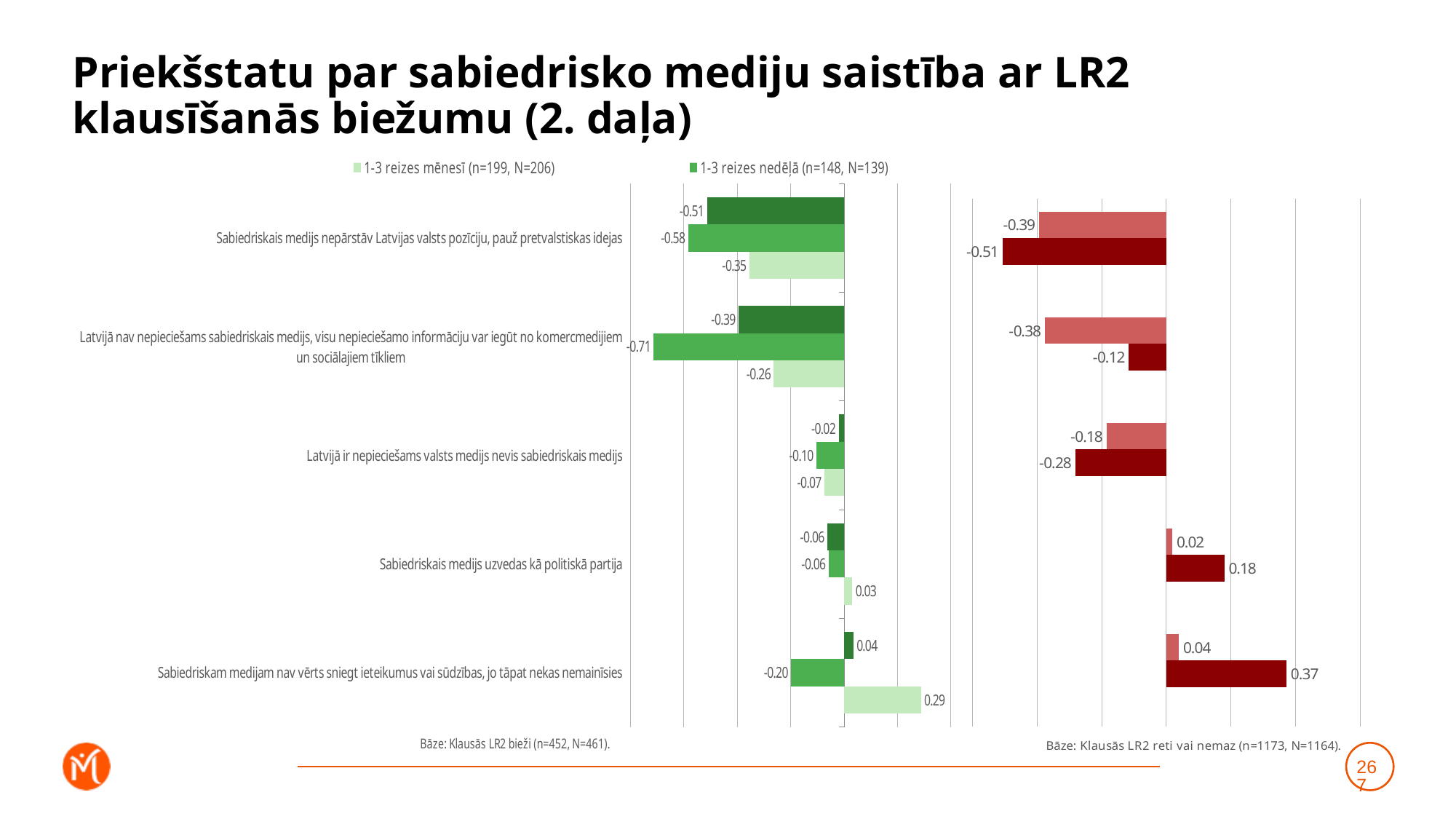
What type of chart is used on this slide? bar chart On the right chart, what is the value of the dark red bar for 'Sabiedriskam medijam nav vērts sniegt ieteikumus vai sūdzības, jo tāpat nekas nemainīsies'? 0.37 On the left chart, what is the value of the '1-3 reizes mēnesī' series for 'Sabiedriskais medijs nepārstāv Latvijas valsts pozīciju, pauž pretvalstiskas idejas'? -0.35 On the left chart, what is the value of the '1-3 reizes nedēļā' series for 'Latvijā nav nepieciešams sabiedriskais medijs, visu nepieciešamo informāciju var iegūt no komercmedijiem un sociālajiem tīkliem'? -0.71 On the left chart, which category has the lowest value in the '1-3 reizes nedēļā' series? Latvijā nav nepieciešams sabiedriskais medijs, visu nepieciešamo informāciju var iegūt no komercmedijiem un sociālajiem tīkliem On the left chart, what is the difference between the '1-3 reizes nedēļā' value (-0.58) and the '1-3 reizes mēnesī' value (-0.35) for 'Sabiedriskais medijs nepārstāv Latvijas valsts pozīciju, pauž pretvalstiskas idejas'? 0.23 On the right chart, what is the value of the lighter red bar for 'Latvijā ir nepieciešams valsts medijs nevis sabiedriskais medijs'? -0.18 How many categories (statements) are shown on the left chart? 5 How many series does the legend at the top of the slide list? 2 On the right chart, for 'Sabiedriskais medijs uzvedas kā politiskā partija', which bar is larger: the lighter red bar or the dark red bar? the dark red bar On the left chart, what is the value of the '1-3 reizes mēnesī' series for 'Sabiedriskam medijam nav vērts sniegt ieteikumus vai sūdzības, jo tāpat nekas nemainīsies'? 0.29 On the right chart, which category has the highest dark red bar value? Sabiedriskam medijam nav vērts sniegt ieteikumus vai sūdzības, jo tāpat nekas nemainīsies